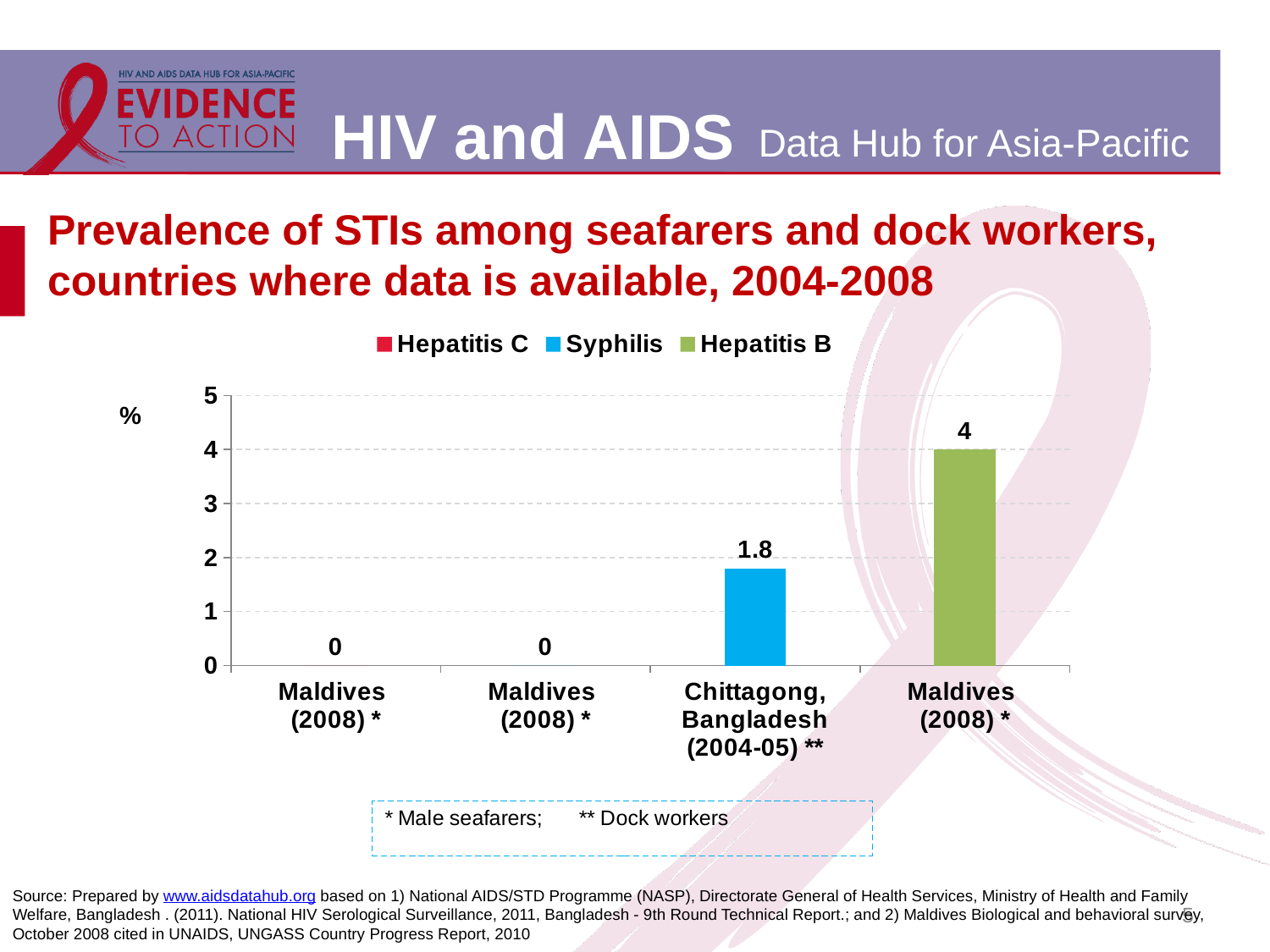
Which is larger: the Hepatitis B value for Maldives (2008) or the Syphilis value for Chittagong, Bangladesh (2004-05)? Hepatitis B value for Maldives (2008) Which category has the highest plotted value? Maldives (2008) * (Hepatitis B) Is the Syphilis value for Chittagong, Bangladesh (2004-05) greater or less than 2? less What kind of chart is shown on the slide? bar chart What is the maximum value shown on the y axis? 5 How many series does the legend list? 3 What is the difference between the Hepatitis B value for Maldives (2008) and the Syphilis value for Chittagong, Bangladesh (2004-05)? 2.2 What is the Syphilis prevalence value shown for Chittagong, Bangladesh (2004-05)? 1.8 What is the Hepatitis B prevalence value shown for Maldives (2008)? 4 What value is labelled on the first bar from the left (Maldives (2008) *)? 0 Which colour represents Syphilis in the legend? blue How many categories are shown along the x axis? 4